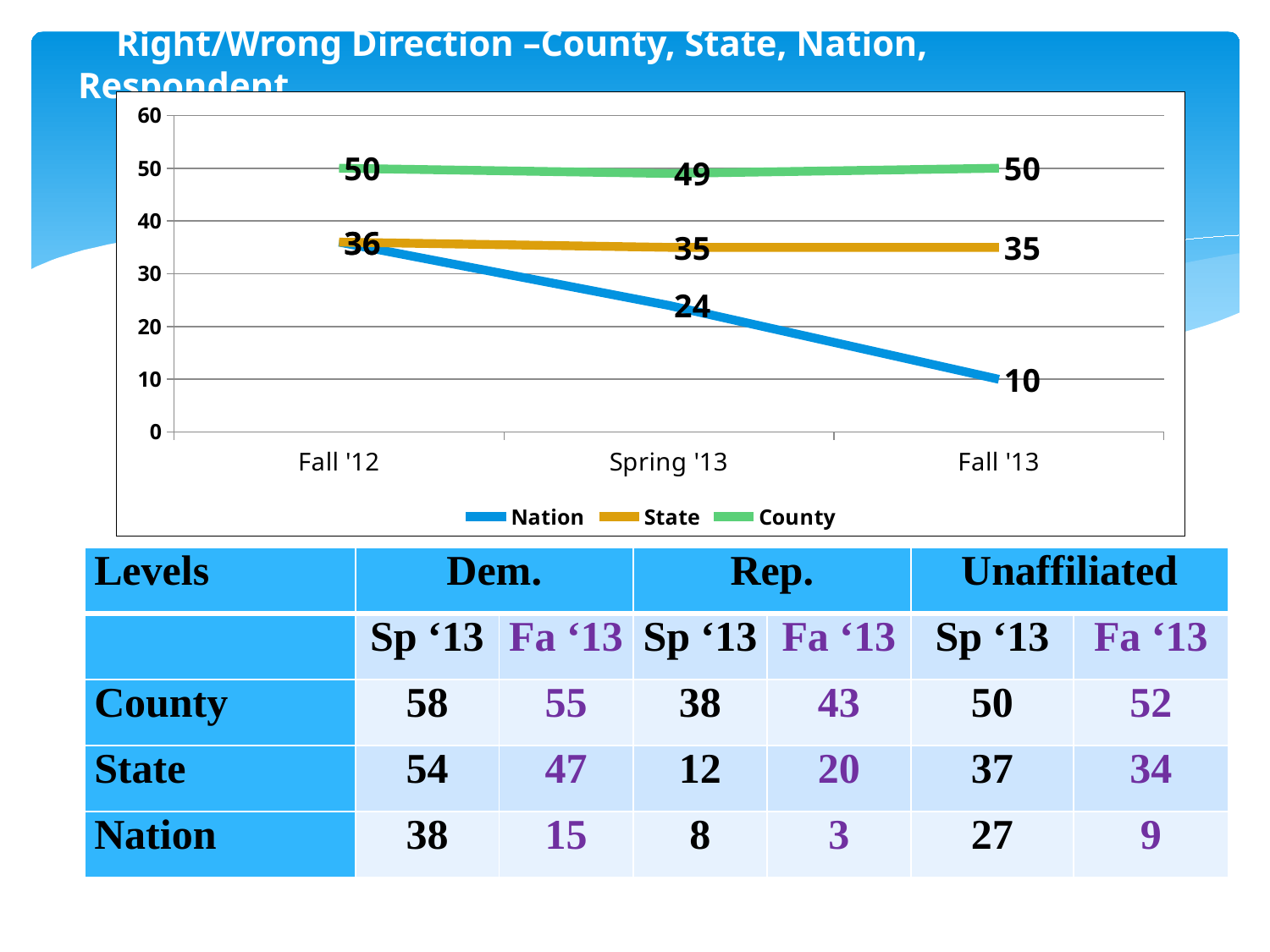
What is the value for County at Spring '13? 49 What is the value for State at Fall '13? 35 How many series does the chart legend list? 3 How many time points are shown on the x axis? 3 What is the value for Nation at Fall '13? 10 Which is larger at Spring '13, the State value or the Nation value? State What type of chart is shown on the slide? line chart What is the value for Nation at Spring '13? 24 Which series has the lowest value at Fall '13? Nation Which series has the highest value at Fall '13? County What is the difference between the County and Nation values at Fall '13? 40 Does the Nation series rise or fall from Fall '12 to Fall '13? fall